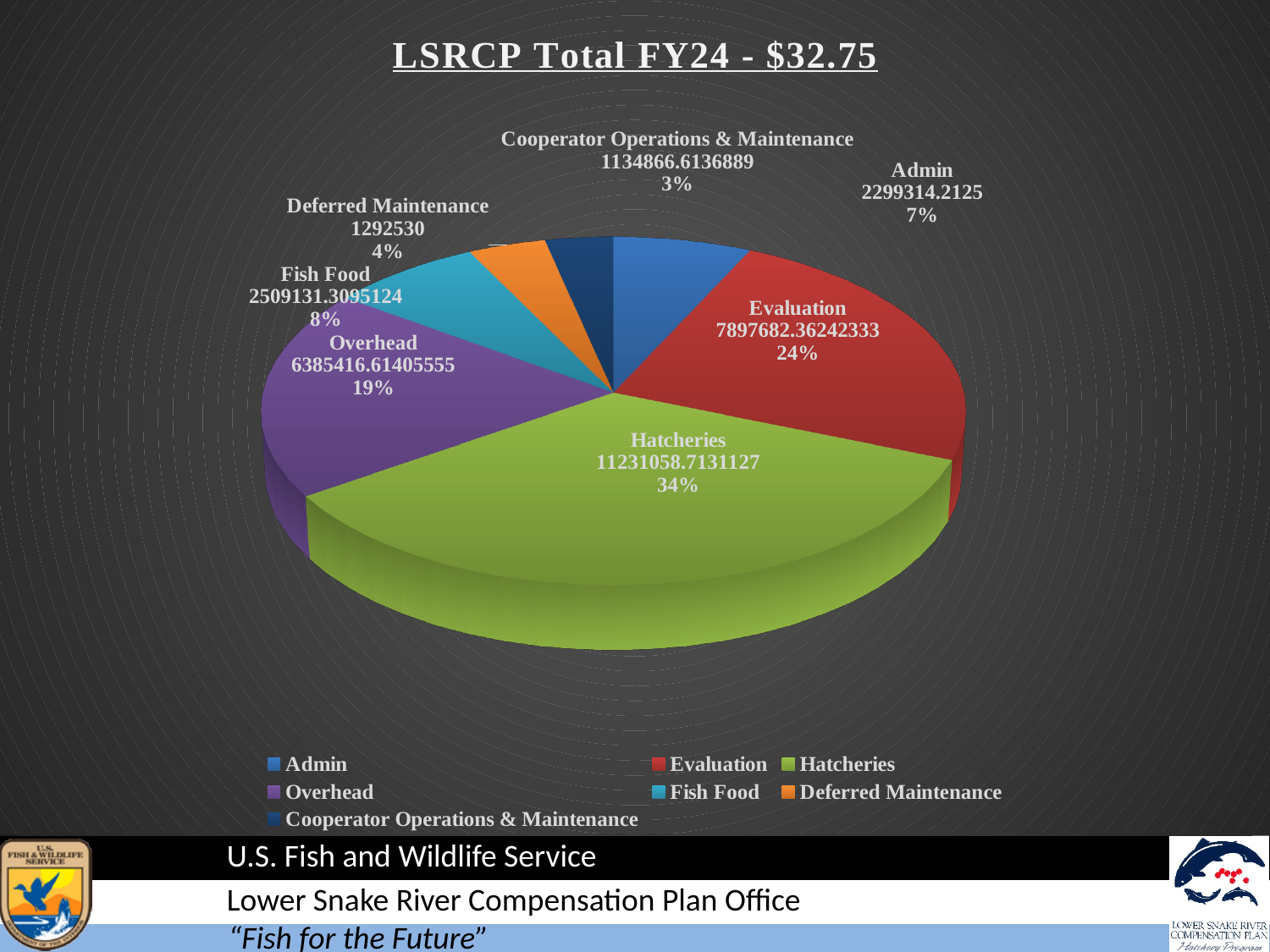
What is the difference in percentage points between the Hatcheries share and the Evaluation share? 10% What is the value shown for Evaluation? 7897682.36242333 What colour is the Hatcheries slice in the pie chart? Green Which is larger, the Fish Food slice or the Admin slice? Fish Food Which category has the largest slice of the pie? Hatcheries What percentage is shown for Overhead? 19% What is the value shown for Deferred Maintenance? 1292530 What kind of chart is shown on the slide? Pie chart Which category has the smallest slice of the pie? Cooperator Operations & Maintenance How many categories does the pie chart show? 7 What share of the pie does Hatcheries represent? 34% What is the title of the chart? LSRCP Total FY24 - $32.75